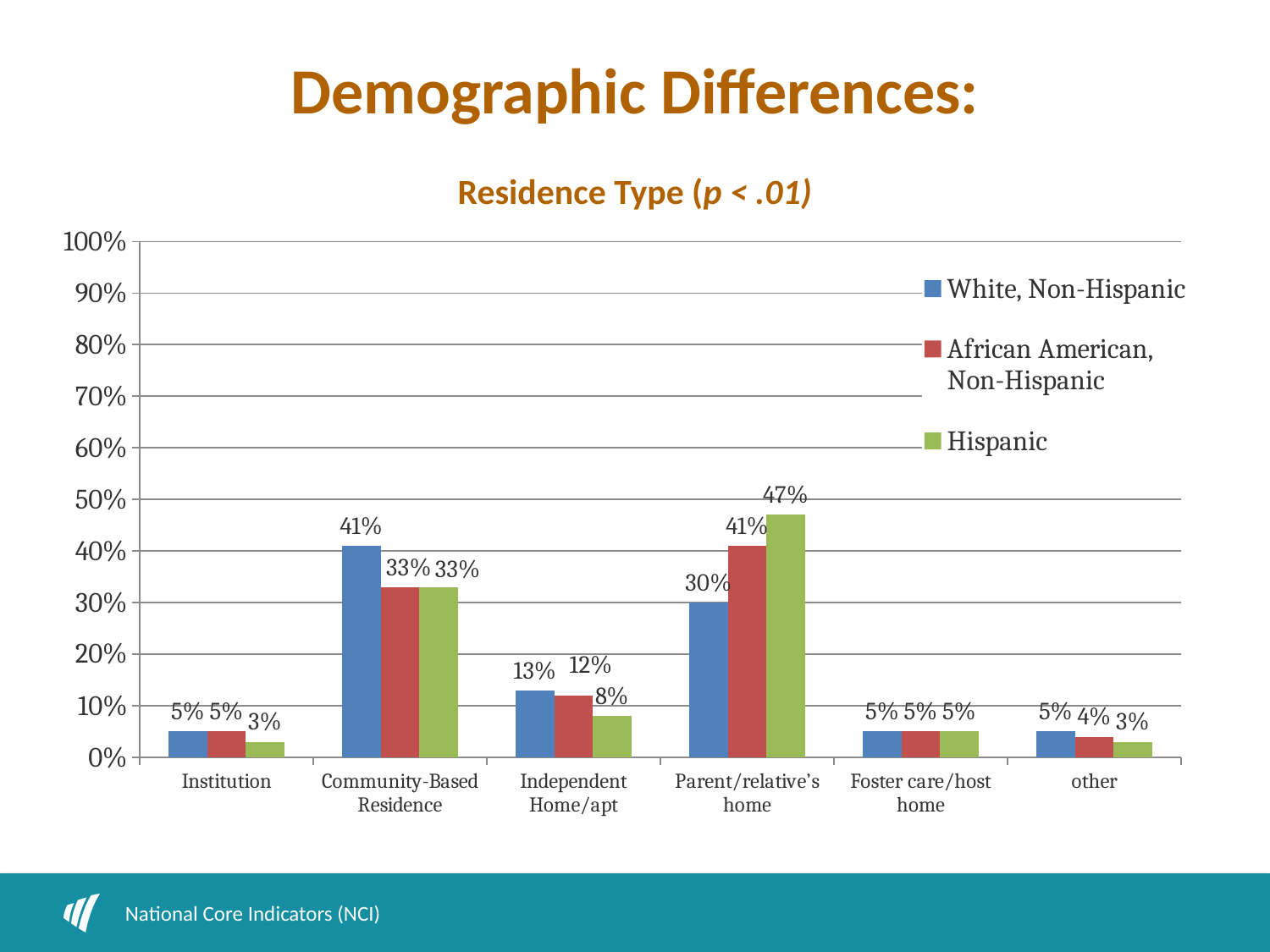
What is the value for African American, Non-Hispanic in the Independent Home/apt category? 12% What is the subtitle of the chart? Residence Type (p < .01) Is the value for African American, Non-Hispanic in Parent/relative's home greater or less than 40%? greater What kind of chart is shown on the slide? Bar chart What is the value for Hispanic in the Parent/relative's home category? 47% Which residence type has the lowest value for White, Non-Hispanic? Institution, Foster care/host home and other (all 5%) Which residence type has the highest value for Hispanic? Parent/relative's home How many residence type categories are shown on the x axis? 6 How many series does the legend list? 3 What is the difference between the Hispanic and White, Non-Hispanic values for Parent/relative's home? 17% What is the value for White, Non-Hispanic in the Community-Based Residence category? 41% Which is larger for Community-Based Residence: White, Non-Hispanic or Hispanic? White, Non-Hispanic